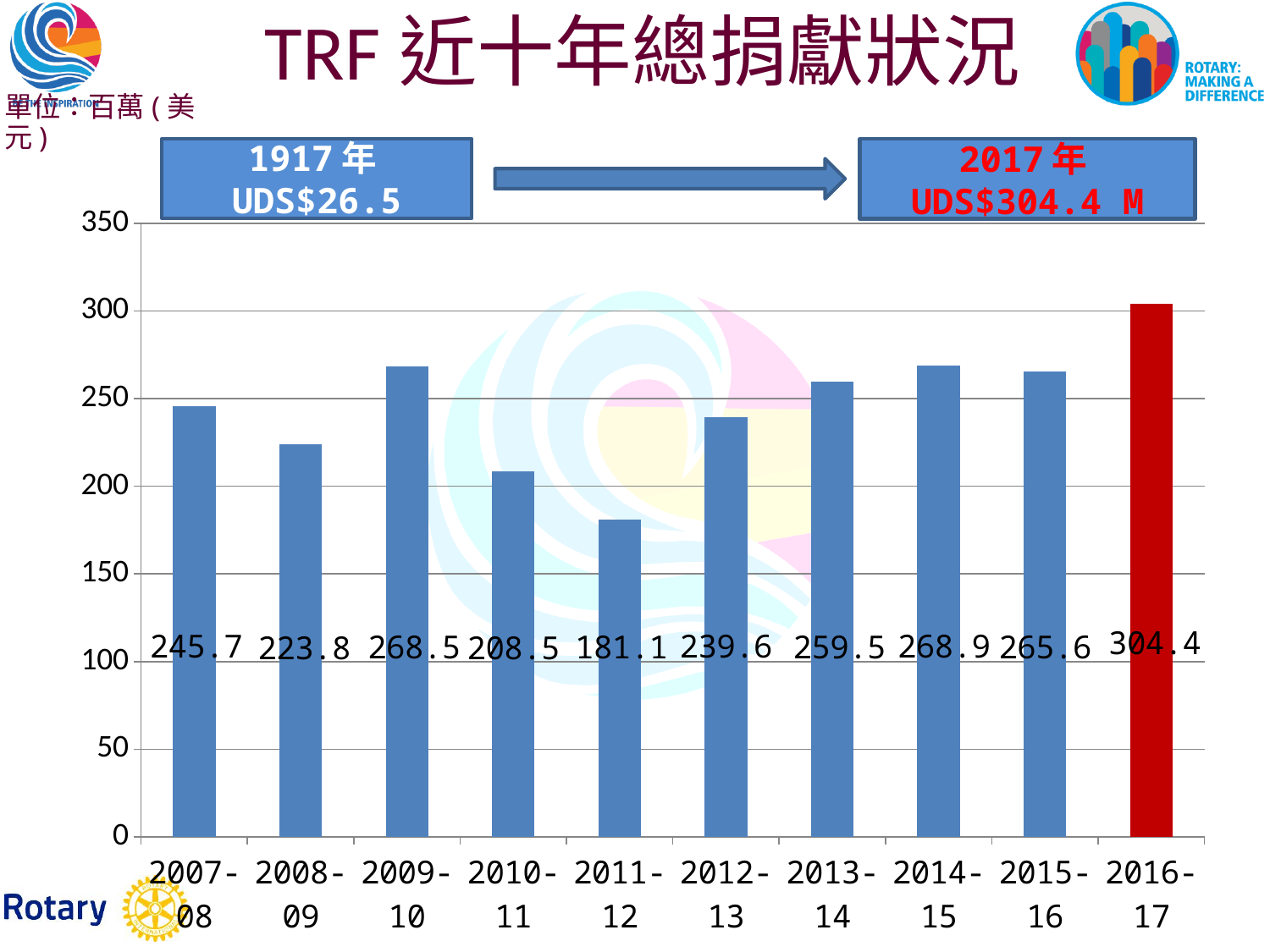
Which year has the highest value? 2016-17 What kind of chart is shown? bar chart Which year has the lowest value? 2011-12 Is the value for 2011-12 greater or less than 200? less What is the value for 2009-10? 268.5 What is the difference between the values for 2016-17 and 2011-12? 123.3 What is the value for 2016-17? 304.4 What is the value for 2011-12? 181.1 What is the difference between the values for 2007-08 and 2008-09? 21.9 Which is larger, the value for 2013-14 or the value for 2012-13? 2013-14 How many years are shown on the x axis? 10 Do the values rise or fall from 2009-10 to 2011-12? fall